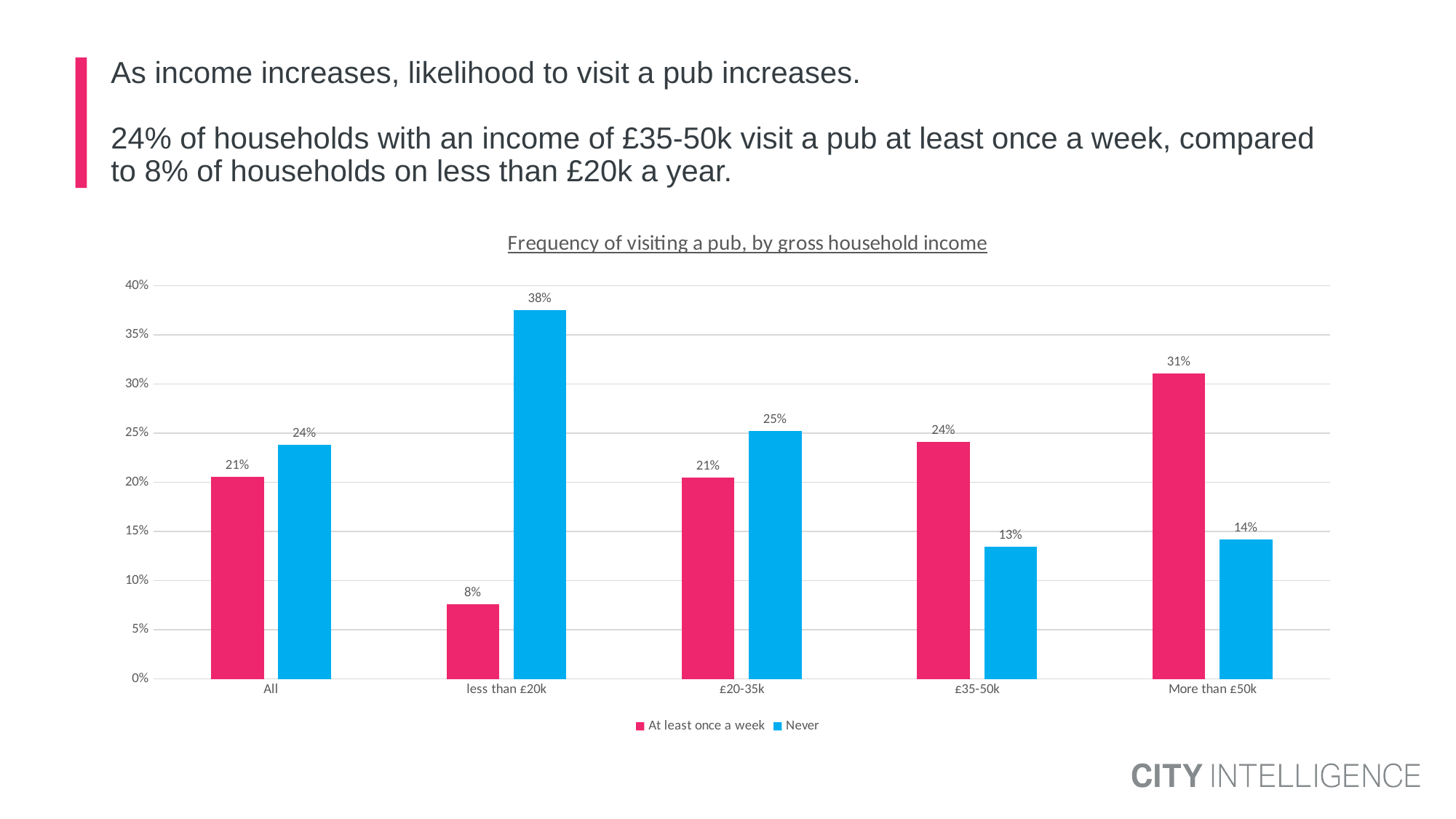
What is the value for 'At least once a week' in the £35-50k category? 24% Which category has the highest value for 'Never'? less than £20k Which category has the lowest value for 'At least once a week'? less than £20k What is the title of the chart? Frequency of visiting a pub, by gross household income In the £20-35k category, which is larger: 'At least once a week' or 'Never'? Never How many income categories are shown on the x axis? 5 What is the difference between the 'Never' and 'At least once a week' values in the 'less than £20k' category? 30% How many series does the legend list? 2 Across the income categories from 'less than £20k' to 'More than £50k', does the 'At least once a week' value rise or fall? Rise What is the value for 'At least once a week' in the 'More than £50k' category? 31% What is the value for 'Never' in the 'less than £20k' category? 38% What kind of chart is shown on the slide? Bar chart